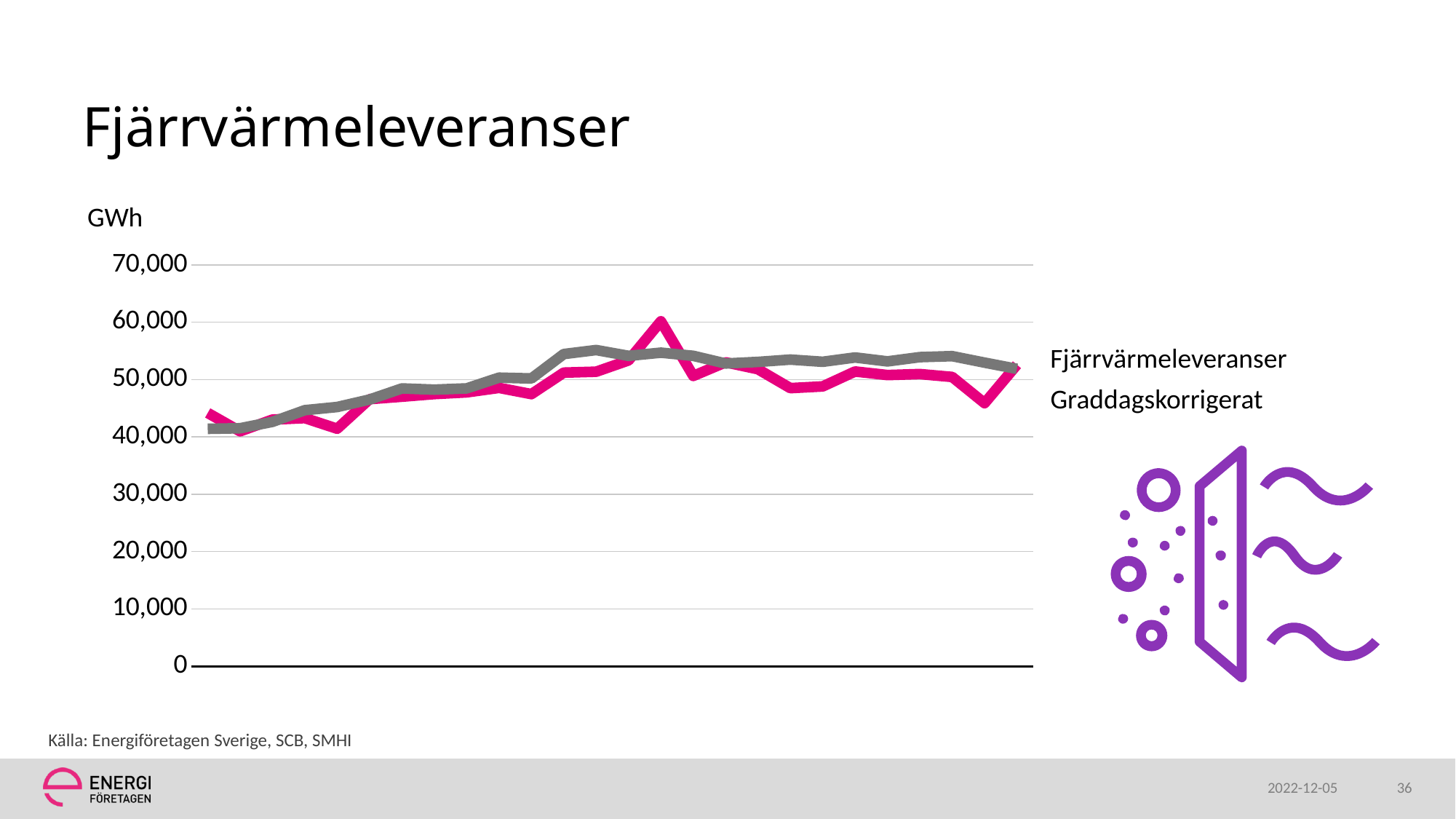
Is the highest value of the Fjärrvärmeleveranser line greater or less than 50,000? greater What kind of chart is shown on the slide? line chart Is the first value of the Graddagskorrigerat line greater or less than 50,000? less Do the values of the Graddagskorrigerat line generally rise or fall from the left to the right of the chart? rise Is the highest value of the Graddagskorrigerat line greater or less than 60,000? less What unit is shown on the y axis of the chart? GWh What is the title of the chart on the slide? Fjärrvärmeleveranser At the highest peak of the chart, which series has the larger value, Fjärrvärmeleveranser or Graddagskorrigerat? Fjärrvärmeleveranser How many series does the chart's legend list? 2 What is the highest value labelled on the y axis of the chart? 70,000